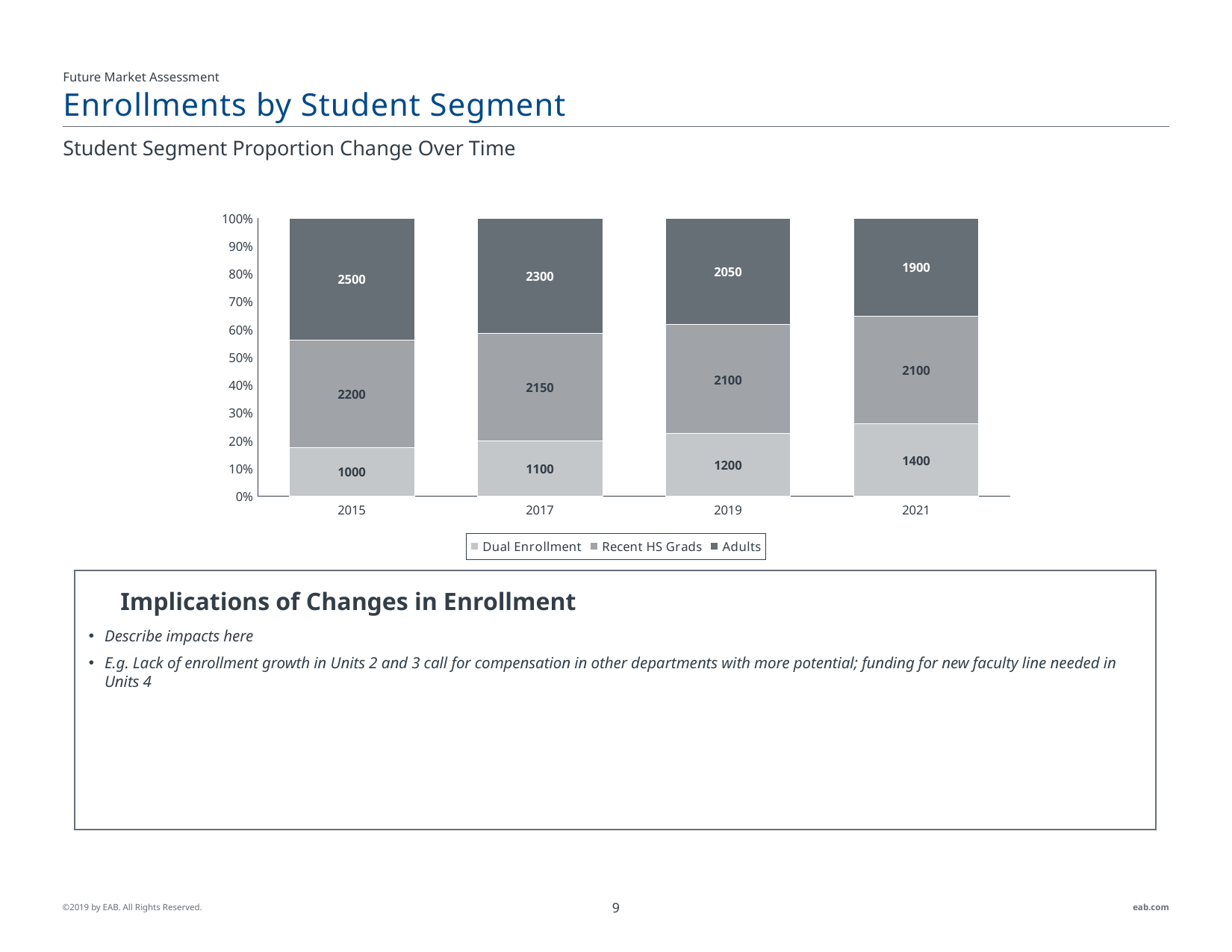
Does the Dual Enrollment value rise or fall from 2015 to 2021? Rise What is the difference between the Adults value in 2015 and in 2021? 600 In which year is the Adults value highest? 2015 What kind of chart is shown? Stacked bar chart What is the total of the three segments in the 2015 bar? 5700 What is the value for Recent HS Grads in 2017? 2150 Which is larger in 2019: Recent HS Grads or Adults? Recent HS Grads What is the value for Dual Enrollment in 2021? 1400 How many years are shown on the x axis? 4 In which year is the Dual Enrollment value lowest? 2015 How many series does the legend list? 3 What is the value for Adults in 2015? 2500